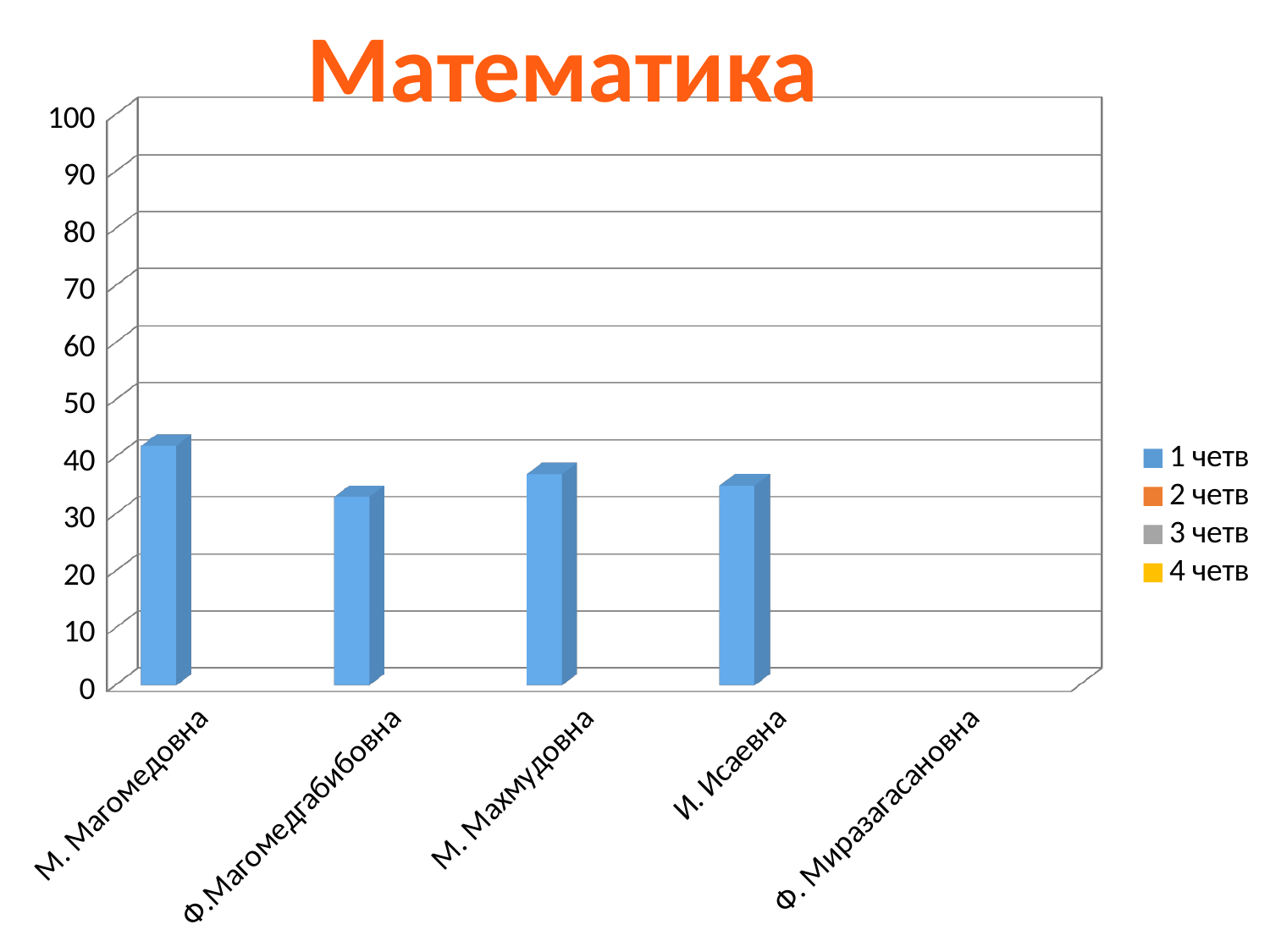
Which is larger, the value for М. Махмудовна or the value for Ф.Магомедгабибовна? М. Махмудовна How many categories are shown on the x axis of the chart? 5 Is the value for М. Махмудовна greater or less than 30? greater Which series in the legend do the plotted bars belong to? 1 четв Is the value for И. Исаевна greater or less than 40? less Is the value for Ф.Магомедгабибовна greater or less than 40? less How many series does the legend list? 4 What is the title of the chart? Математика Which is larger, the value for М. Магомедовна or the value for Ф.Магомедгабибовна? М. Магомедовна What kind of chart is shown on the slide? bar chart Which category has the highest bar? М. Магомедовна